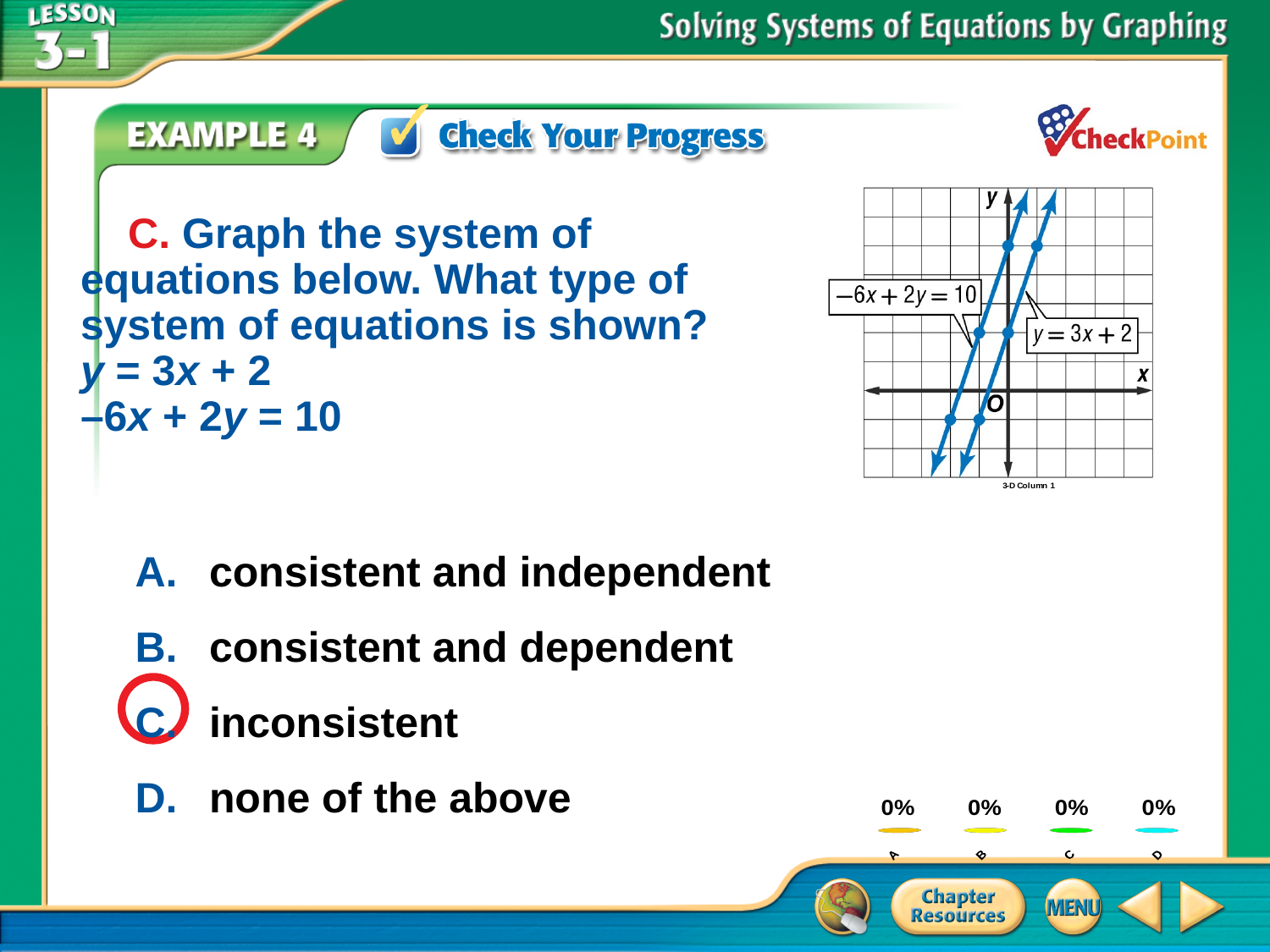
In the small bar chart at the bottom right of the slide, what is the value shown for category A? 0% In the small bar chart at the bottom right of the slide, what is the difference between the values for A and D? 0% In the small bar chart at the bottom right of the slide, how many categories are shown on the x axis? 4 What kind of chart is the small chart at the bottom right of the slide with categories A, B, C and D? bar chart In the small bar chart at the bottom right of the slide, what is the value shown for category C? 0% In the small bar chart at the bottom right of the slide, what is the value shown for category D? 0% In the small bar chart at the bottom right of the slide, what is the total of the values for A, B, C and D? 0% In the small bar chart at the bottom right of the slide, what are the category labels along the x axis? A, B, C, D In the small bar chart at the bottom right of the slide, what is the value shown for category B? 0%